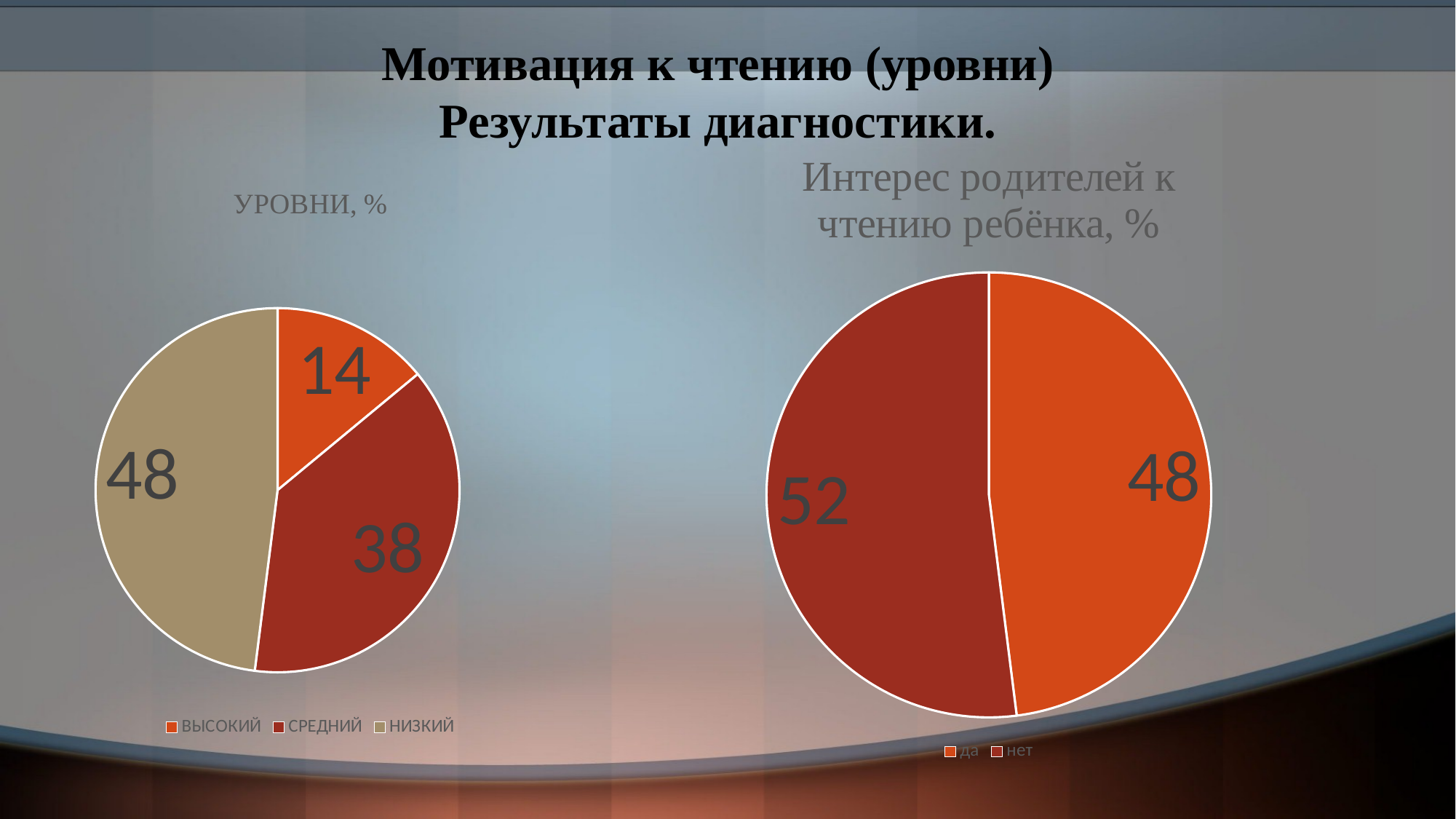
In the chart titled "УРОВНИ, %", what is the value for ВЫСОКИЙ? 14 What kind of chart is the chart titled "Интерес родителей к чтению ребёнка, %"? Pie chart In the chart titled "Интерес родителей к чтению ребёнка, %", what is the difference between the values for нет and да? 4 In the chart titled "Интерес родителей к чтению ребёнка, %", what is the value for да? 48 In the chart titled "УРОВНИ, %", what is the value for СРЕДНИЙ? 38 In the chart titled "УРОВНИ, %", what is the difference between the values for НИЗКИЙ and ВЫСОКИЙ? 34 In the chart titled "Интерес родителей к чтению ребёнка, %", what is the value for нет? 52 In the chart titled "УРОВНИ, %", how many categories does the legend list? 3 In the chart titled "Интерес родителей к чтению ребёнка, %", which is larger, да or нет? нет In the chart titled "УРОВНИ, %", what is the value for НИЗКИЙ? 48 In the chart titled "УРОВНИ, %", which category has the smallest slice? ВЫСОКИЙ In the chart titled "УРОВНИ, %", which category has the largest slice? НИЗКИЙ